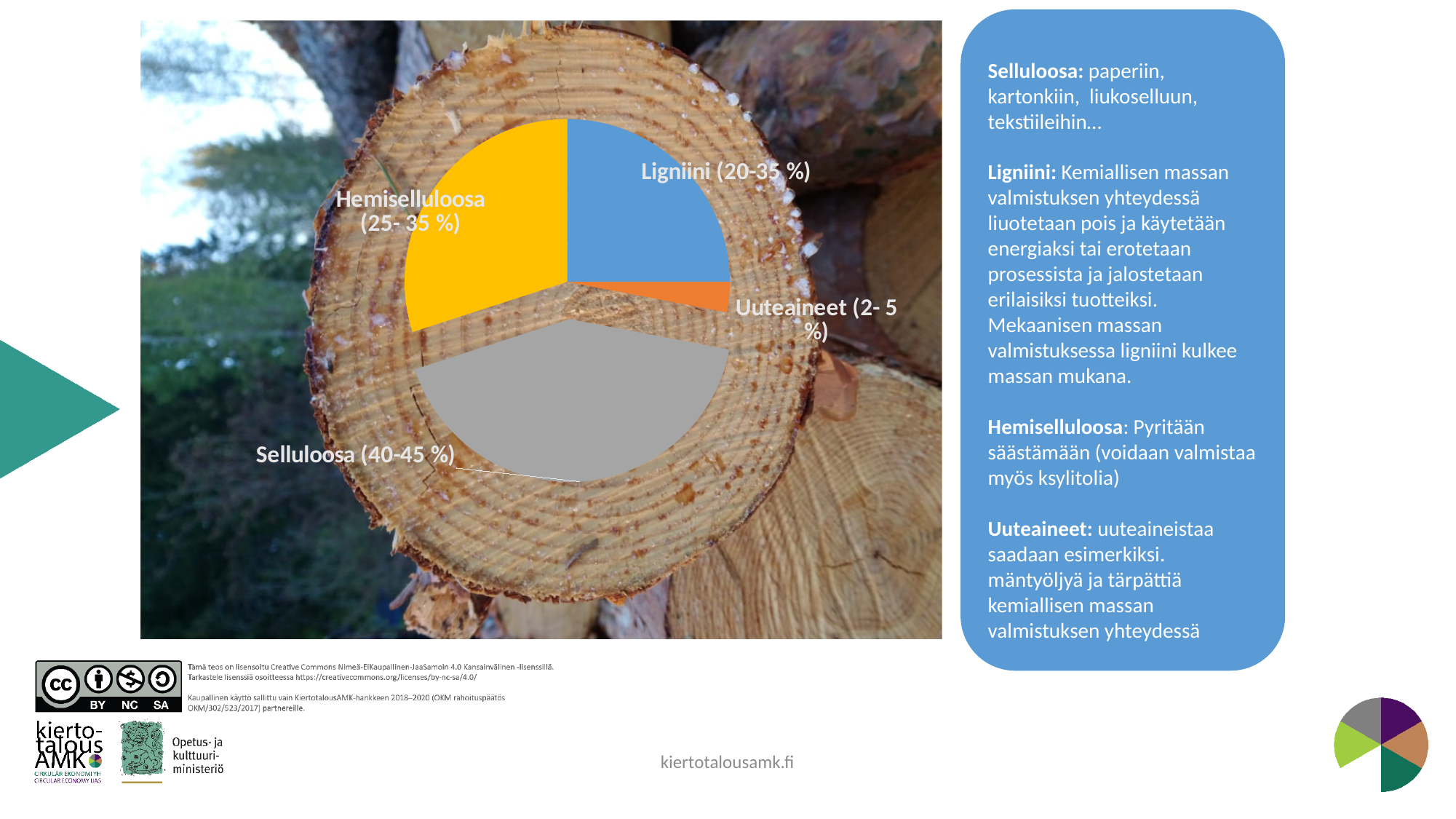
Which slice is larger in the pie chart, Selluloosa or Uuteaineet? Selluloosa What percentage range is shown for Selluloosa in the pie chart? 40-45 % Which component has the smallest slice in the pie chart? Uuteaineet What kind of chart is shown on the slide? Pie chart What percentage range is shown for Ligniini in the pie chart? 20-35 % How many slices does the pie chart have? 4 What percentage range is shown for Hemiselluloosa in the pie chart? 25- 35 % Which component has the largest slice in the pie chart? Selluloosa Which slice is larger in the pie chart, Hemiselluloosa or Uuteaineet? Hemiselluloosa What colour is the Selluloosa slice in the pie chart? Grey What percentage range is shown for Uuteaineet in the pie chart? 2- 5 % What colour is the Hemiselluloosa slice in the pie chart? Yellow